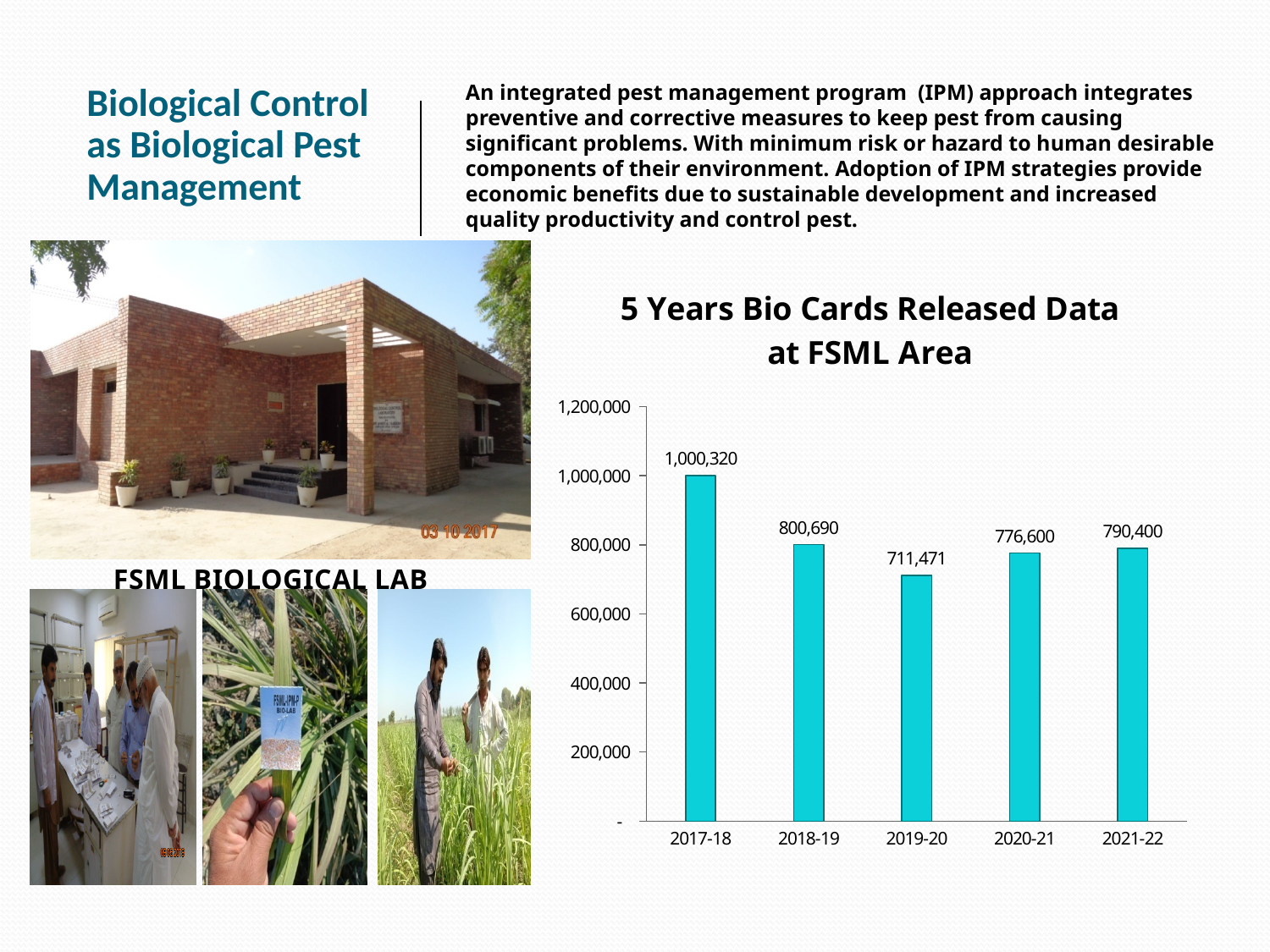
Which is larger, the value for 2018-19 or the value for 2021-22? 2018-19 Which year has the lowest value in the chart? 2019-20 Is the value for 2020-21 greater or less than 800,000? less What is the value for 2017-18 in the chart? 1,000,320 What is the value for 2019-20 in the chart? 711,471 What is the difference between the values for 2017-18 and 2018-19? 199,630 What is the title of the chart? 5 Years Bio Cards Released Data at FSML Area What is the difference between the values for 2021-22 and 2020-21? 13,800 What is the value for 2021-22 in the chart? 790,400 How many years are shown on the x axis of the chart? 5 What kind of chart is shown on the slide? bar chart Which year has the highest value in the chart? 2017-18